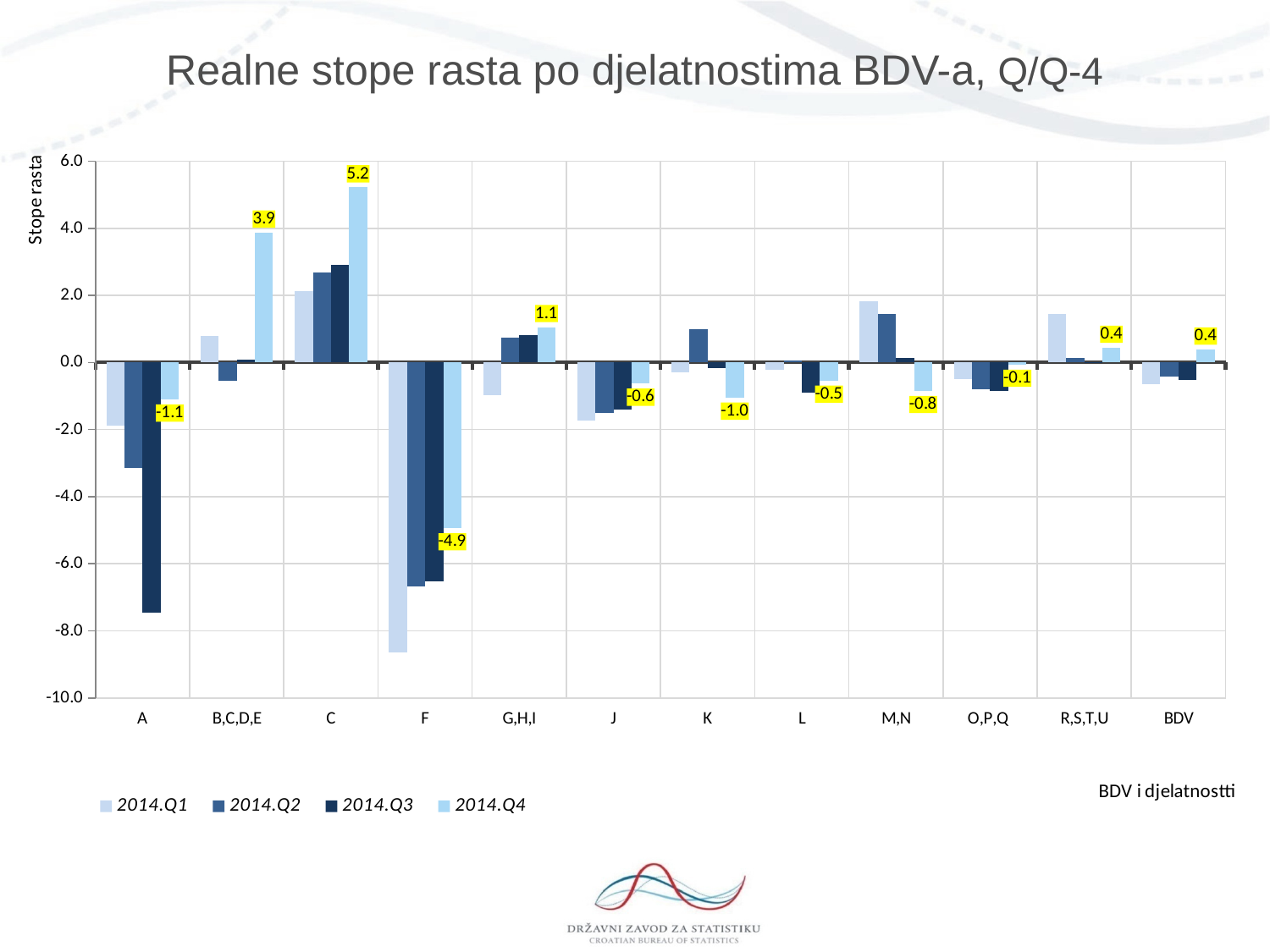
How many series does the legend list? 4 Which is larger, the 2014.Q4 value for G,H,I or for J? G,H,I Which category has the highest 2014.Q4 value? C Which category has the lowest 2014.Q4 value? F What is the 2014.Q4 value for category C? 5.2 What kind of chart is shown on the slide? bar chart What is the 2014.Q4 value for category B,C,D,E? 3.9 How many categories are shown on the x axis? 12 What is the 2014.Q4 value for BDV? 0.4 What is the difference between the 2014.Q4 values for C and B,C,D,E? 1.3 Is the 2014.Q1 value for category F greater or less than -8.0? less What is the 2014.Q4 value for category F? -4.9